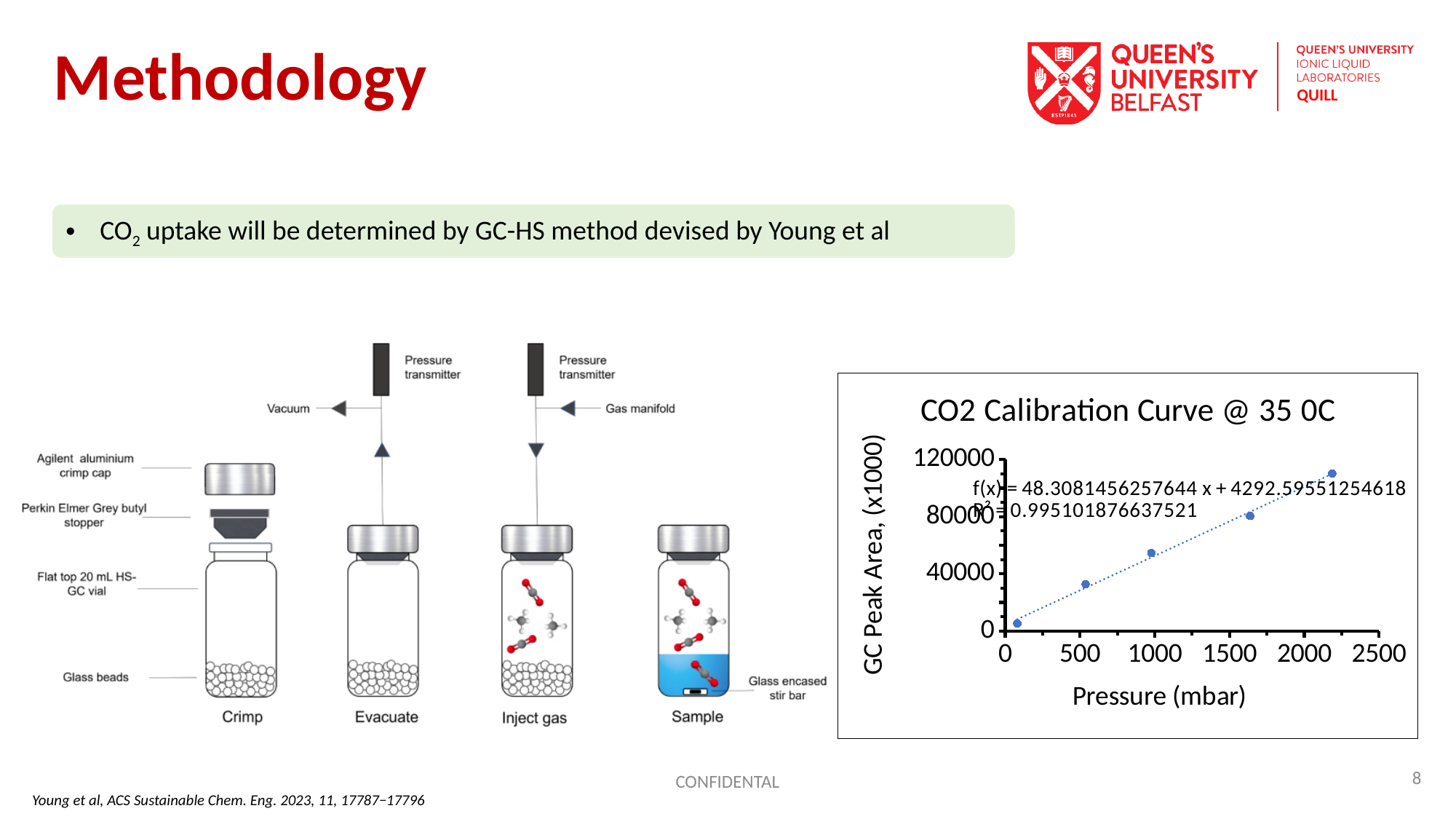
What kind of chart is the CO2 Calibration Curve @ 35 0C? scatter chart On the CO2 Calibration Curve @ 35 0C chart, is the GC peak area of the point at the lowest pressure greater or less than 40000? less On the CO2 Calibration Curve @ 35 0C chart, which point has the higher GC peak area: the one at the lowest pressure or the one at the highest pressure? the one at the highest pressure What is the title of the chart on the slide? CO2 Calibration Curve @ 35 0C On the CO2 Calibration Curve @ 35 0C chart, which point has the lowest GC peak area? the point at the lowest pressure How many data points are plotted on the CO2 Calibration Curve @ 35 0C chart? 5 What R² value is printed on the CO2 Calibration Curve @ 35 0C chart? 0.995101876637521 On the CO2 Calibration Curve @ 35 0C chart, does GC peak area rise or fall as pressure increases? rise On the CO2 Calibration Curve @ 35 0C chart, is the GC peak area of the point near 500 mbar greater or less than 40000? less On the CO2 Calibration Curve @ 35 0C chart, is the GC peak area of the point at the highest pressure greater or less than 80000? greater